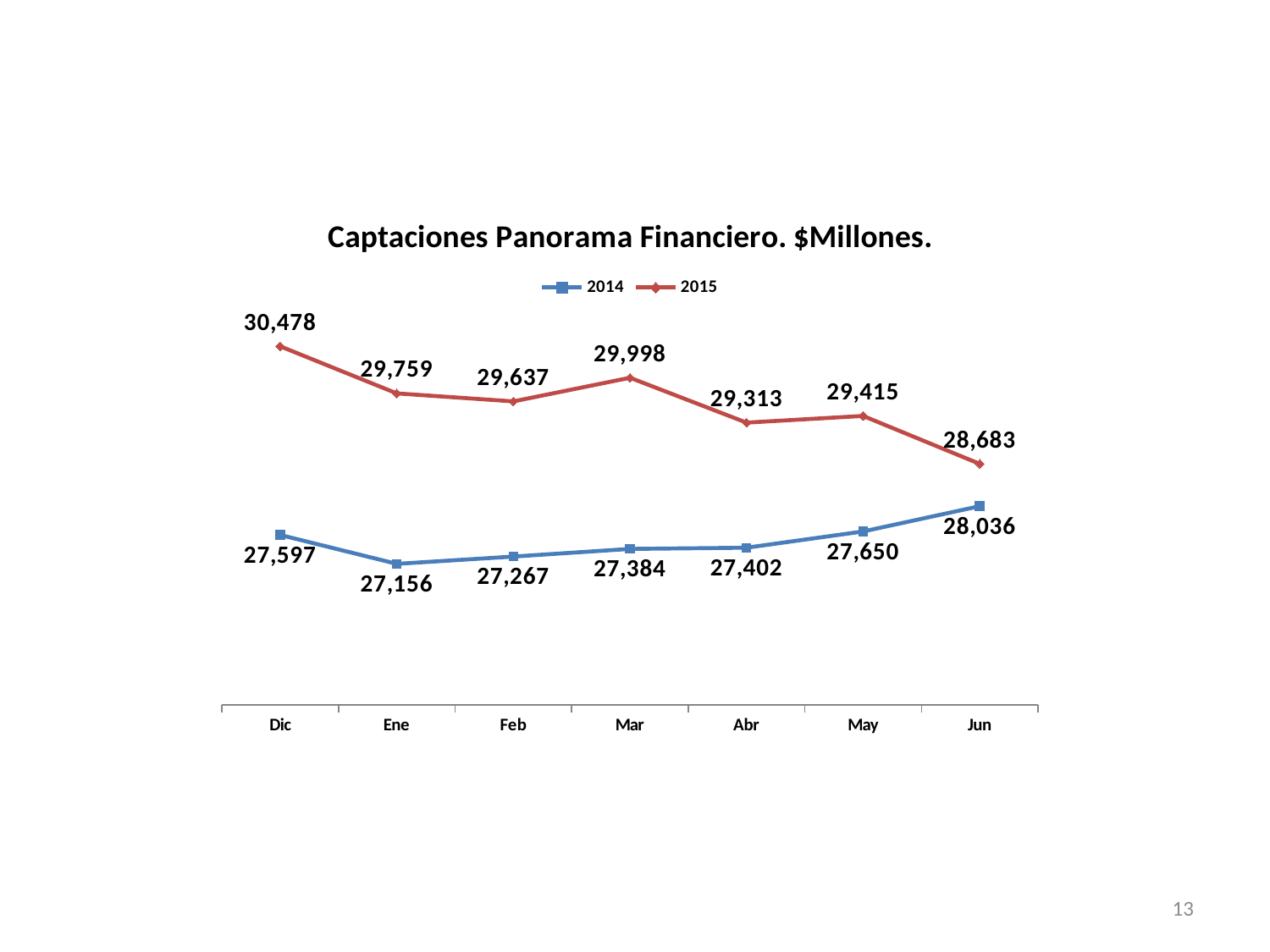
How many series does the legend list? 2 What is the value for 2014 in Ene? 27,156 What is the value for 2015 in Mar? 29,998 What is the difference between the 2015 and 2014 values in Dic? 2,881 Which is larger, the 2015 value in Abr or the 2015 value in May? May In which month is the 2015 series lowest? Jun What kind of chart is this? Line chart What is the value for 2015 in Dic? 30,478 What is the value for 2014 in Jun? 28,036 Does the 2015 series generally rise or fall from Dic to Jun? Fall In which month is the 2014 series highest? Jun How many months are shown on the x axis? 7